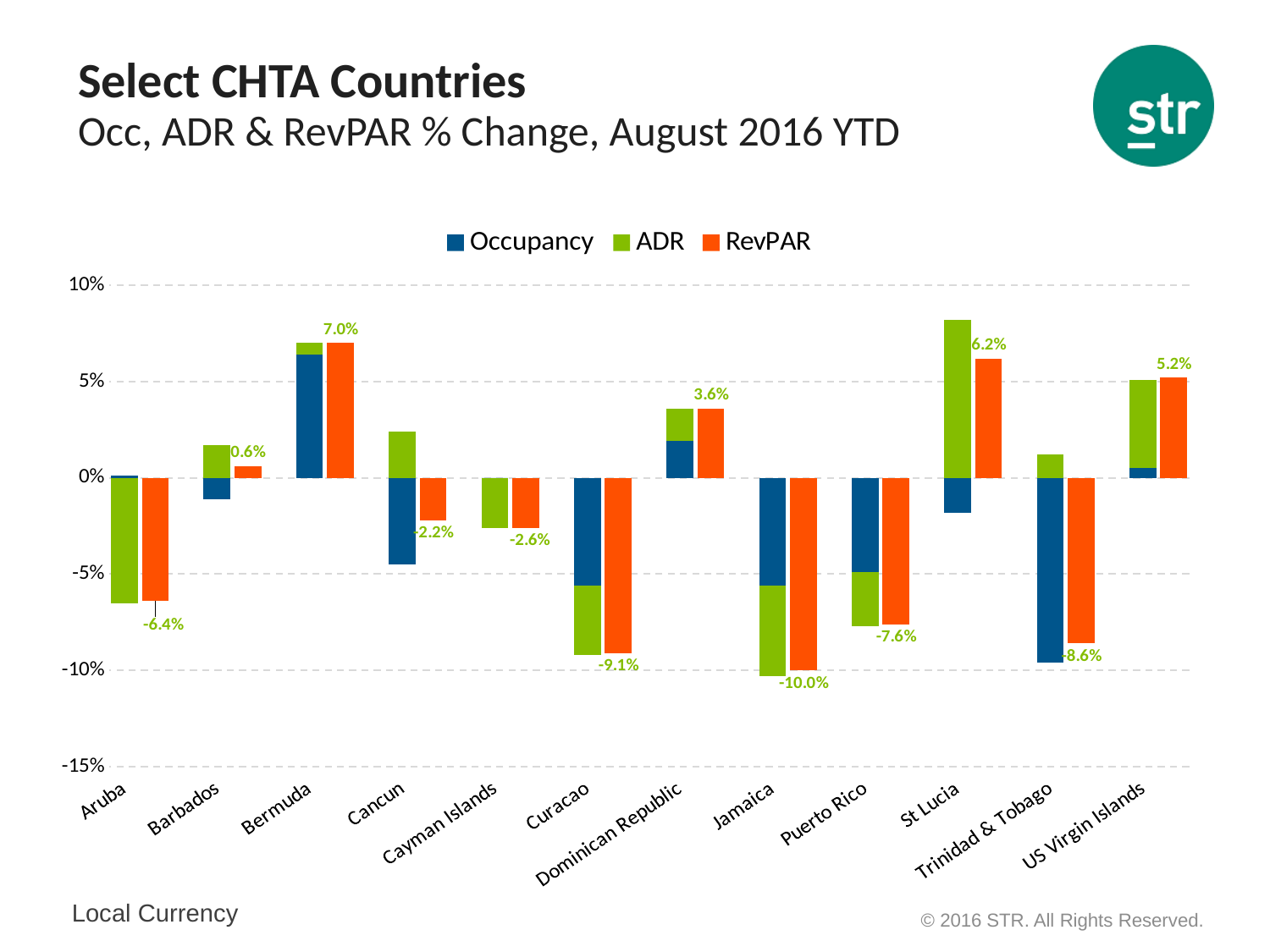
How many countries are shown on the x axis? 12 Which has the larger RevPAR % change, Curacao or Trinidad & Tobago? Trinidad & Tobago What kind of chart is shown on the slide? Bar chart Which country has the lowest RevPAR % change? Jamaica What is the difference between the RevPAR % change for Bermuda and St Lucia? 0.8 percentage points What is the RevPAR % change for Bermuda? 7.0% What is the RevPAR % change for Cayman Islands? -2.6% Which country has the highest RevPAR % change? Bermuda What is the RevPAR % change for Jamaica? -10.0% How many series does the legend list? 3 Is the Occupancy % change for Trinidad & Tobago greater or less than -5%? less Is the ADR % change for St Lucia greater or less than 5%? greater